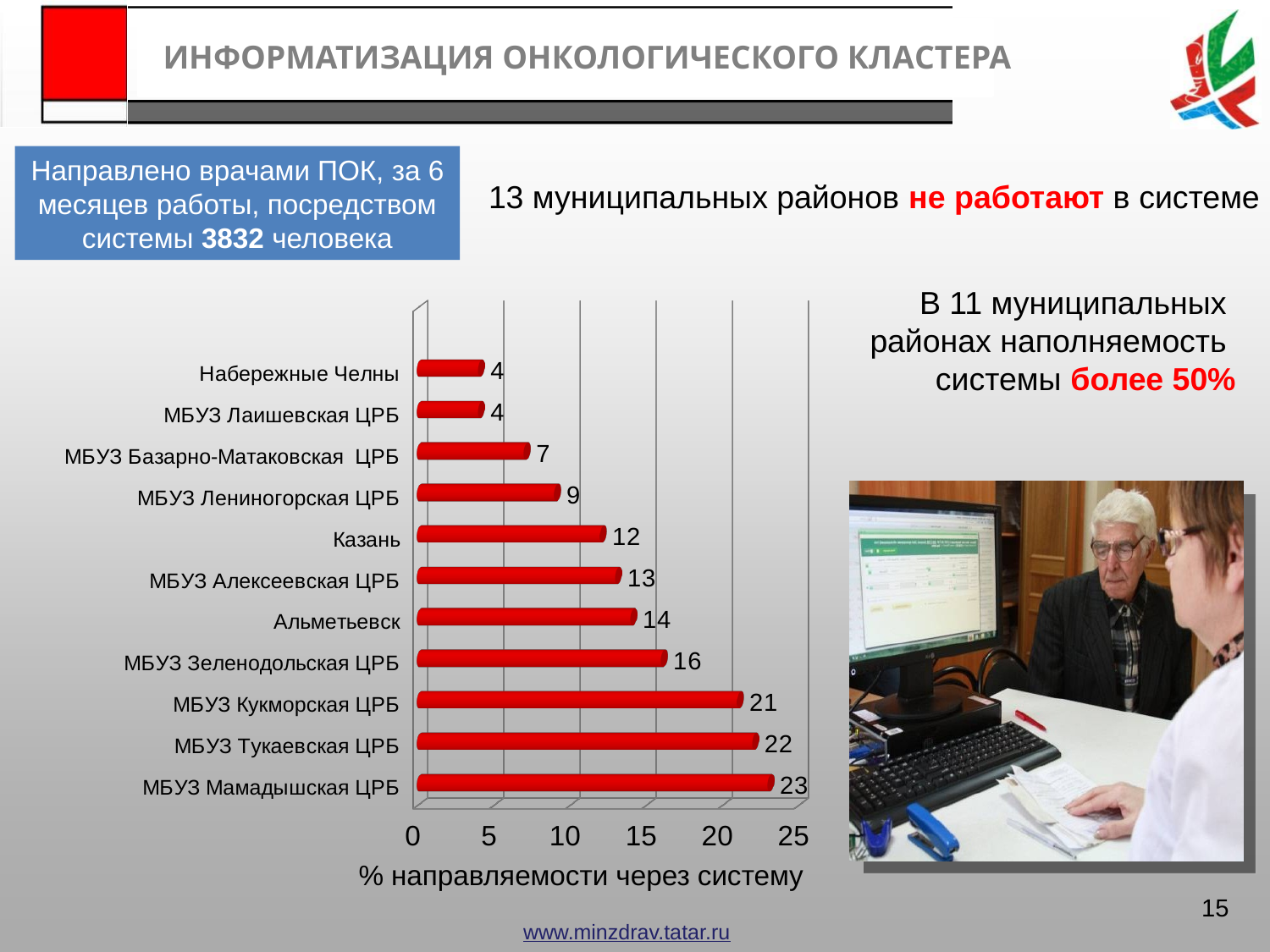
How many categories are shown in the chart? 11 What is the value for МБУЗ Лениногорская ЦРБ? 9 What is the difference between the values for МБУЗ Зеленодольская ЦРБ and Набережные Челны? 12 What is the title of the horizontal axis of the chart? % направляемости через систему What is the value for МБУЗ Кукморская ЦРБ? 21 What is the value for Казань? 12 Is the value for МБУЗ Тукаевская ЦРБ greater or less than 20? greater What is the difference between the values for МБУЗ Мамадышская ЦРБ and МБУЗ Тукаевская ЦРБ? 1 Which is larger, the value for МБУЗ Алексеевская ЦРБ or the value for МБУЗ Базарно-Матаковская ЦРБ? МБУЗ Алексеевская ЦРБ What kind of chart is shown on the slide? bar chart What is the value for Альметьевск? 14 Which category has the highest value? МБУЗ Мамадышская ЦРБ